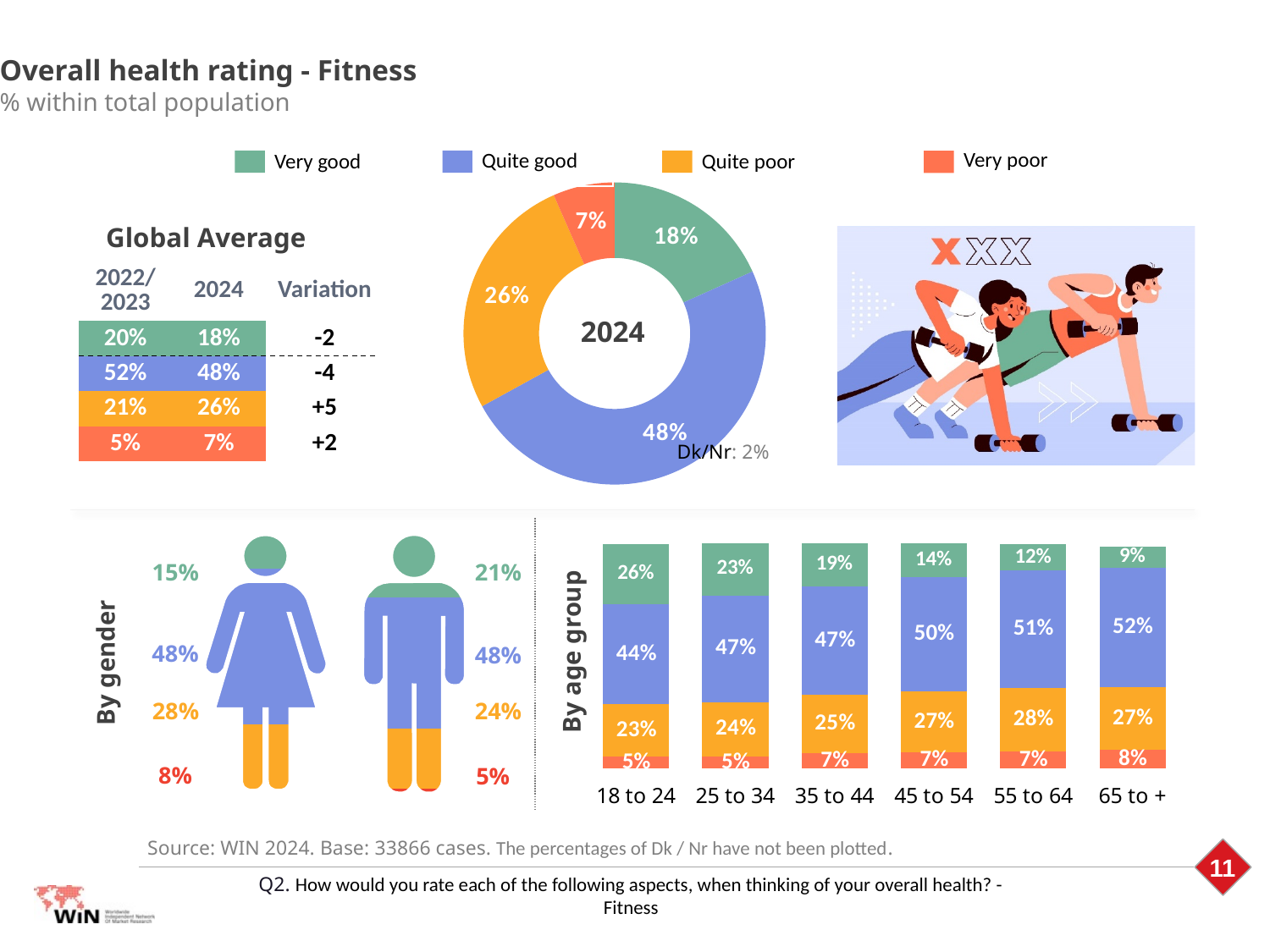
In the 'By age group' chart, does the 'Very good' value rise or fall as age increases from 18 to 24 to 65 to +? Fall In the 2024 donut chart, what is the difference between the 'Quite poor' share and the 'Very good' share? 8 percentage points In the 2024 donut chart, which rating category has the largest share? Quite good In the 'By age group' chart, which age group has the highest 'Quite good' value? 65 to + In the 2024 donut chart, what share of respondents rated their fitness as 'Quite good'? 48% In the 'By age group' chart, what is the 'Very good' value for the 18 to 24 group? 26% What kind of chart is the 'By age group' chart? Stacked bar chart In the 'By gender' chart, what is the 'Very good' value for men? 21% In the 'By age group' chart, how many age groups are shown? 6 In the 2024 donut chart, which rating category has the smallest share? Very poor In the 'By age group' chart, which is larger: the 'Quite poor' value for 55 to 64 or for 18 to 24? 55 to 64 How many series does the legend above the donut chart list? 4